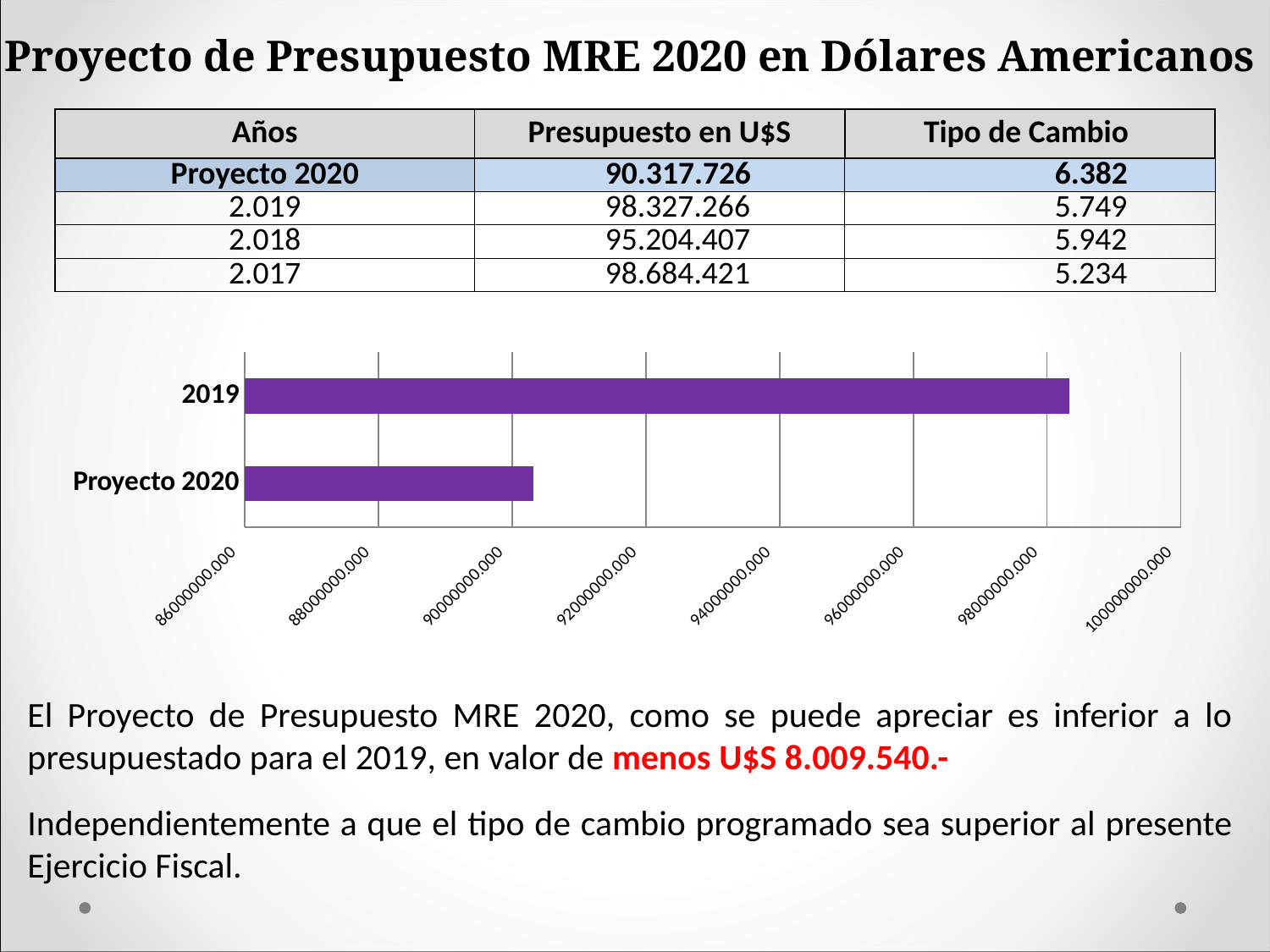
Which category has the shortest bar in the chart? Proyecto 2020 Is the value for Proyecto 2020 in the chart greater or less than 92000000.000? less By how much is the Proyecto 2020 budget lower than the 2019 budget, as stated on the slide? U$S 8.009.540 Which category has the longest bar in the chart? 2019 Which bar is longer, 2019 or Proyecto 2020? 2019 How many categories (bars) does the chart show? 2 According to the table on the slide, what is the Presupuesto en U$S for 2.019? 98.327.266 According to the table on the slide, what is the Presupuesto en U$S for Proyecto 2020? 90.317.726 Is the value for Proyecto 2020 in the chart greater or less than 90000000.000? greater What kind of chart is shown on the slide? bar chart Is the value for 2019 in the chart greater or less than 96000000.000? greater What colour are the bars in the chart? purple